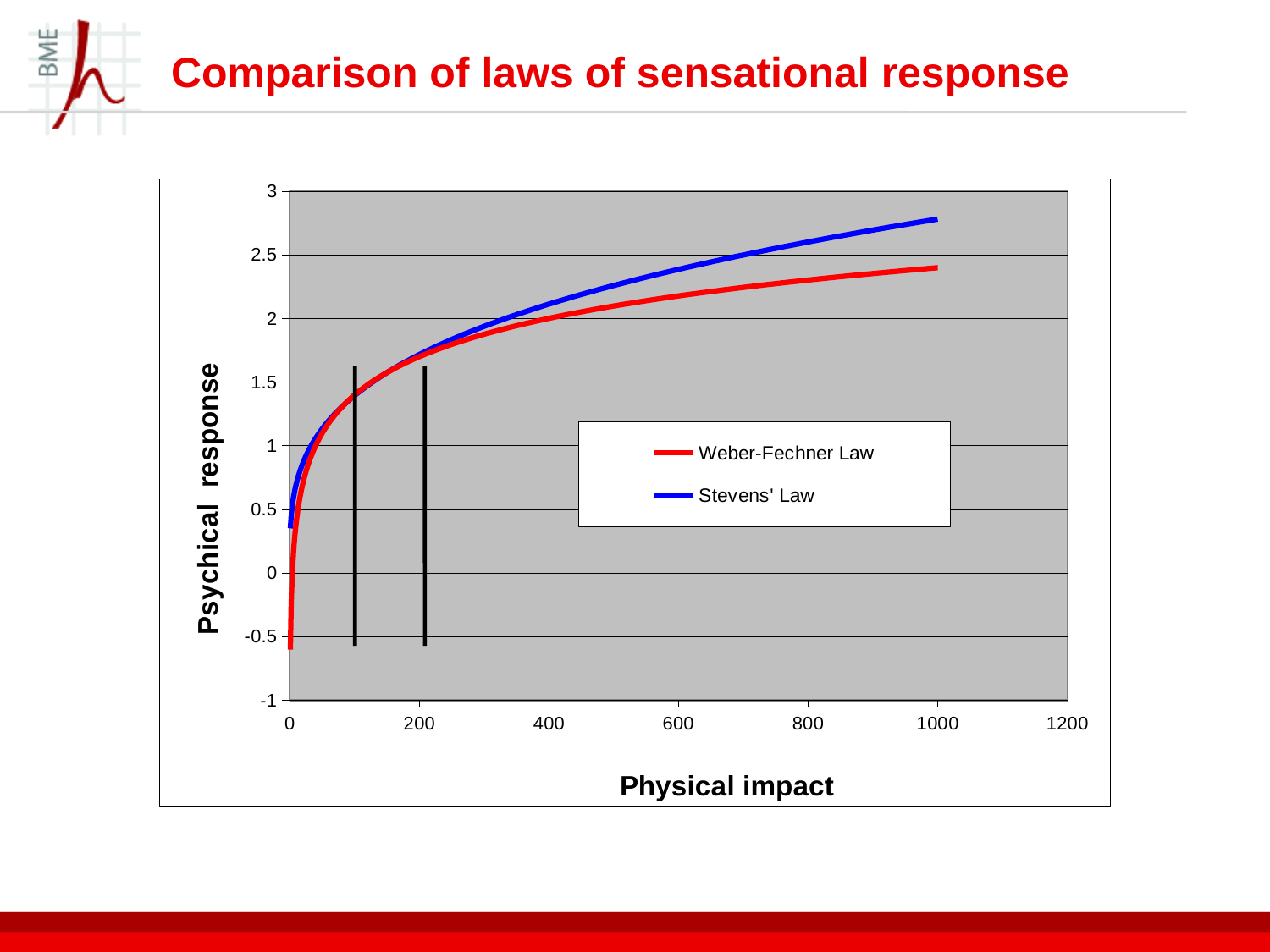
What is the title of the x axis? Physical impact What are the two series named in the legend? Weber-Fechner Law and Stevens' Law At a Physical impact of 800, which curve has the higher Psychical response, Weber-Fechner Law or Stevens' Law? Stevens' Law Is the Psychical response of the Stevens' Law curve at a Physical impact of 1000 greater or less than 2.5? greater At a Physical impact of 1000, which curve has the higher Psychical response, Weber-Fechner Law or Stevens' Law? Stevens' Law Is the Psychical response of the Stevens' Law curve at a Physical impact of 200 greater or less than 2? less Do the values of the Stevens' Law curve rise or fall as Physical impact increases? rise Is the Psychical response of the Weber-Fechner Law curve at a Physical impact of 1000 greater or less than 2.5? less How many series does the legend list? 2 Do the values of the Weber-Fechner Law curve rise or fall as Physical impact increases? rise What kind of chart is shown on the slide? line chart